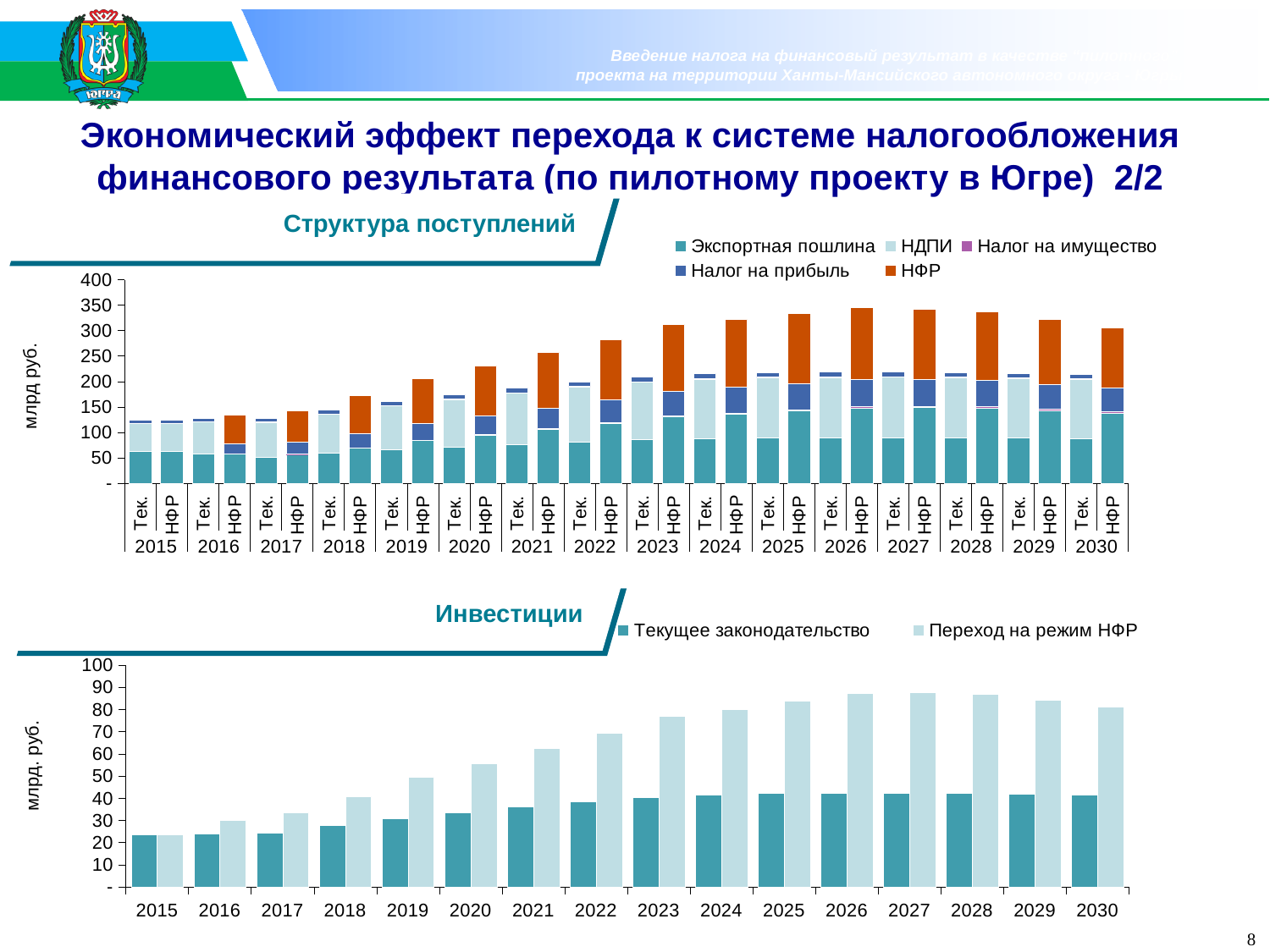
In the 'Структура поступлений' chart, is the total of the 'НФР' bar for 2016 greater or less than 150? less In the 'Инвестиции' chart, do the values for 'Переход на режим НФР' rise or fall from 2015 to 2020? rise How many series does the legend of the 'Инвестиции' chart list? 2 How many series does the legend of the 'Структура поступлений' chart list? 5 In the 'Инвестиции' chart, is the value for 'Переход на режим НФР' in 2027 greater or less than 80? greater In the 'Инвестиции' chart, which year has the lowest value for 'Переход на режим НФР'? 2015 In the 'Инвестиции' chart, is the value for 'Текущее законодательство' in 2015 greater or less than 30? less In the 'Инвестиции' chart, which is larger in 2030: 'Текущее законодательство' or 'Переход на режим НФР'? Переход на режим НФР How many years are shown on the x axis of the 'Инвестиции' chart? 16 What kind of chart is the 'Инвестиции' chart at the bottom of the slide? bar chart